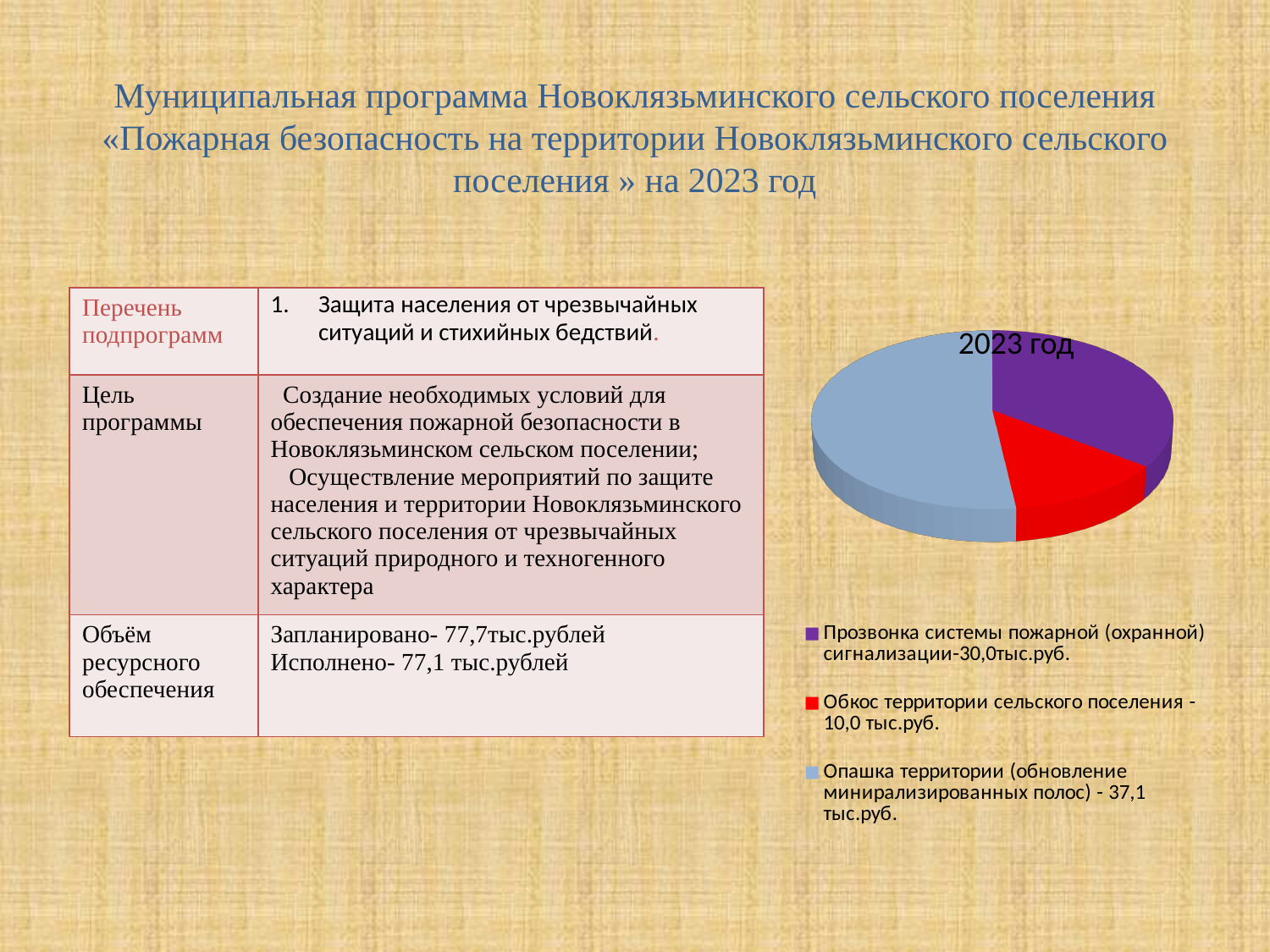
What kind of chart is shown on the slide? pie chart Which item in the pie chart has the largest amount? Опашка территории (обновление минирализированных полос) What is the title of the pie chart? 2023 год What colour is the slice for 'Обкос территории сельского поселения' in the pie chart? red Which item in the pie chart has the smallest amount? Обкос территории сельского поселения What amount is given for 'Опашка территории (обновление минирализированных полос)' in the pie chart legend? 37,1 тыс.руб. What amount is given for 'Обкос территории сельского поселения' in the pie chart legend? 10,0 тыс.руб. By how much does the amount for 'Опашка территории' exceed the amount for 'Прозвонка системы пожарной (охранной) сигнализации'? 7,1 тыс.руб. How many entries does the legend of the pie chart list? 3 How many slices does the pie chart have? 3 What amount is given for 'Прозвонка системы пожарной (охранной) сигнализации' in the pie chart legend? 30,0 тыс.руб. Which is larger in the pie chart: the amount for 'Прозвонка системы пожарной (охранной) сигнализации' or for 'Обкос территории сельского поселения'? Прозвонка системы пожарной (охранной) сигнализации